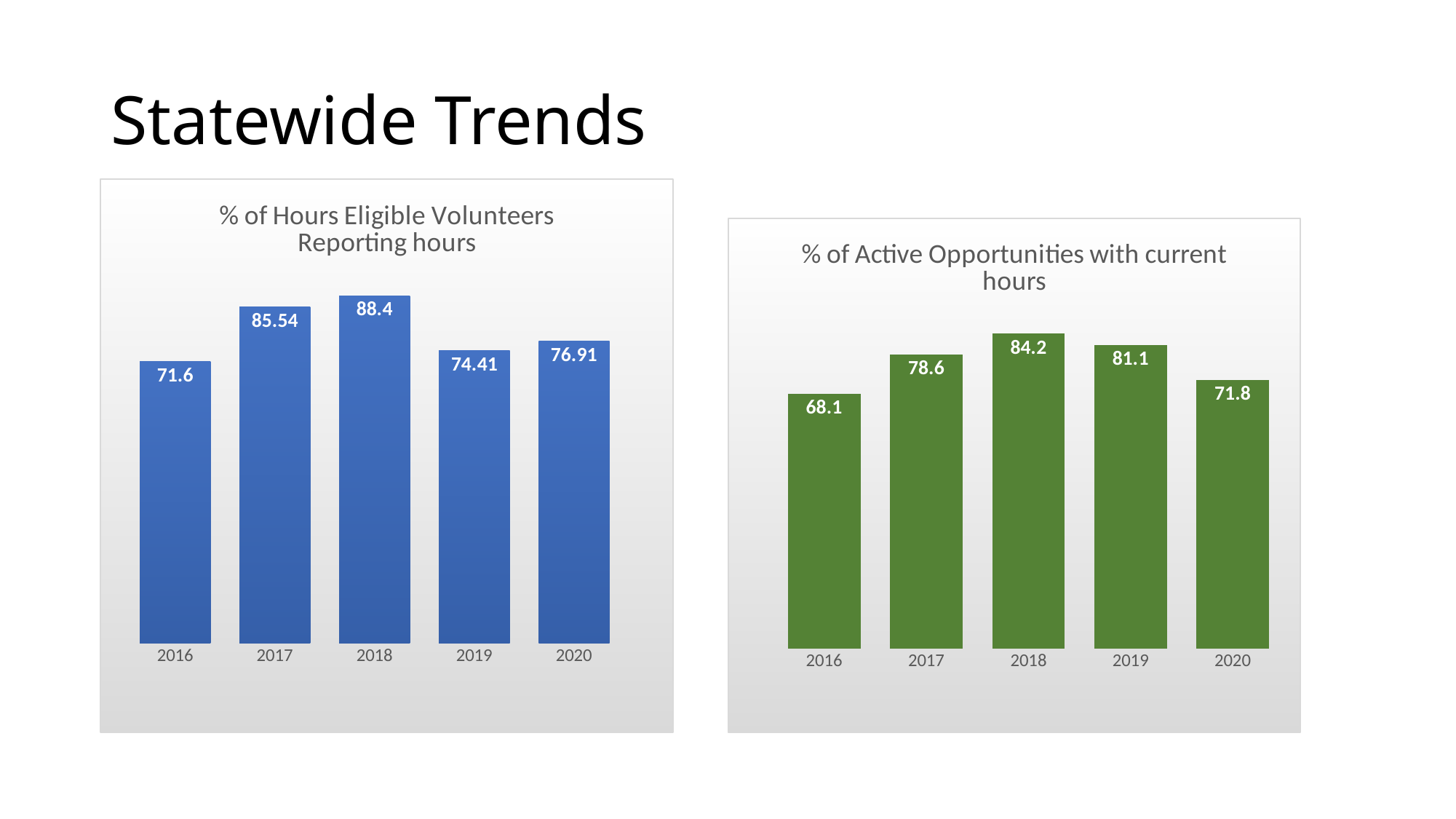
In the '% of Hours Eligible Volunteers Reporting hours' chart, which year has the highest value? 2018 In the '% of Hours Eligible Volunteers Reporting hours' chart, what is the difference between the 2018 and 2019 values? 13.99 In the '% of Active Opportunities with current hours' chart, what is the value for 2019? 81.1 What colour are the bars in the '% of Hours Eligible Volunteers Reporting hours' chart? Blue In the '% of Active Opportunities with current hours' chart, which year has the lowest value? 2016 In the '% of Active Opportunities with current hours' chart, which year has the highest value? 2018 In the '% of Hours Eligible Volunteers Reporting hours' chart, what is the value for 2017? 85.54 What type of chart is the '% of Active Opportunities with current hours' chart? Bar chart In the '% of Hours Eligible Volunteers Reporting hours' chart, how many years are shown? 5 In the '% of Active Opportunities with current hours' chart, what is the difference between the 2018 and 2020 values? 12.4 In the '% of Hours Eligible Volunteers Reporting hours' chart, which year has the lowest value? 2016 In the '% of Active Opportunities with current hours' chart, is the value for 2017 or 2020 larger? 2017